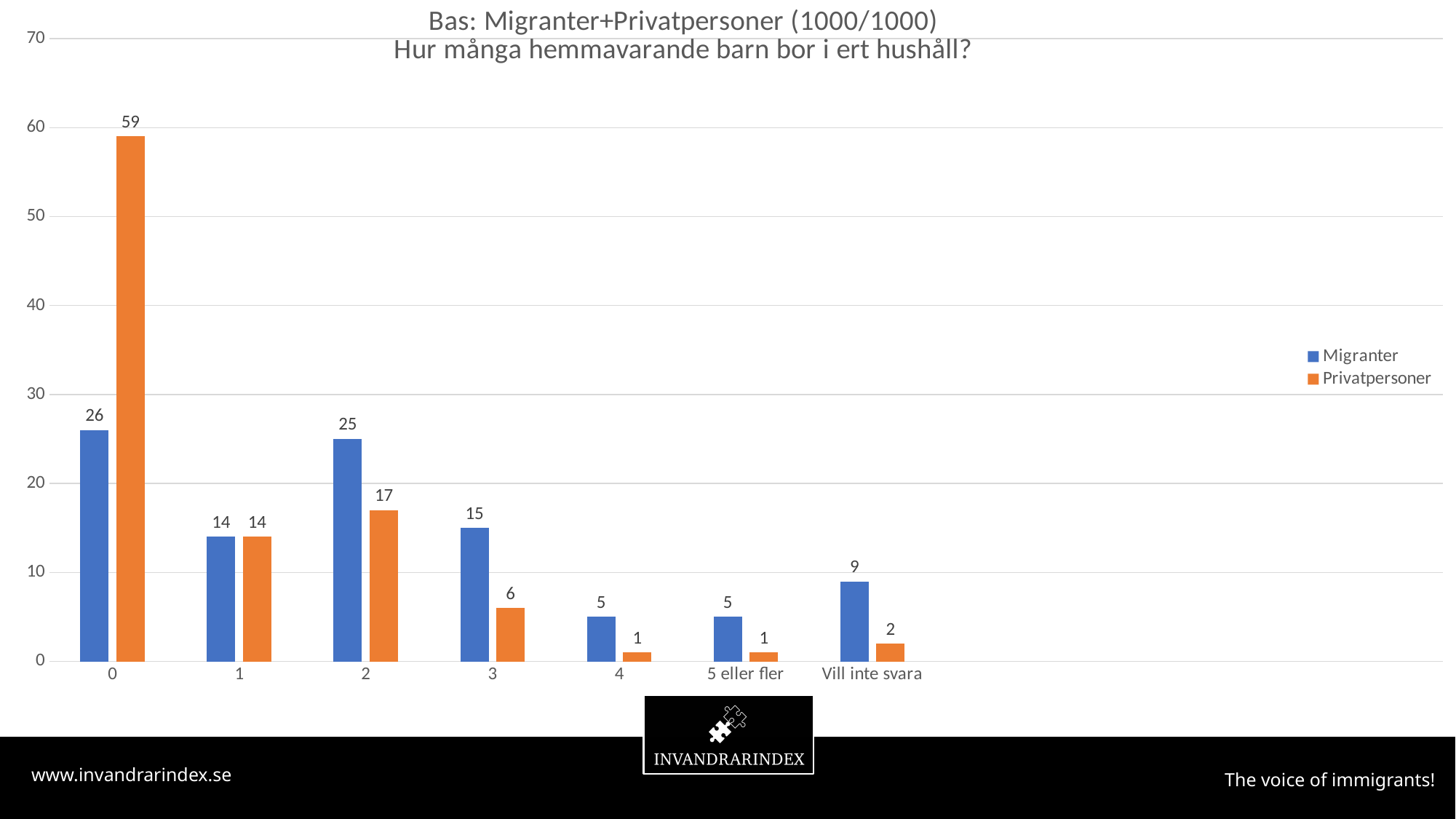
What kind of chart is shown on the slide? Bar chart Which is larger in the "3" category, Migranter or Privatpersoner? Migranter What is the value for Privatpersoner in the "2" category? 17 Which category has the highest value for Privatpersoner? 0 What is the value for Migranter in the "0" category? 26 What is the value for Migranter in the "Vill inte svara" category? 9 What is the value for Privatpersoner in the "0" category? 59 How many categories are shown on the x axis? 7 How many series does the legend list? 2 What is the difference between Privatpersoner and Migranter in the "0" category? 33 Which colour represents Privatpersoner in the chart? Orange Which category has the lowest value for Migranter? 4 and 5 eller fler (both 5)